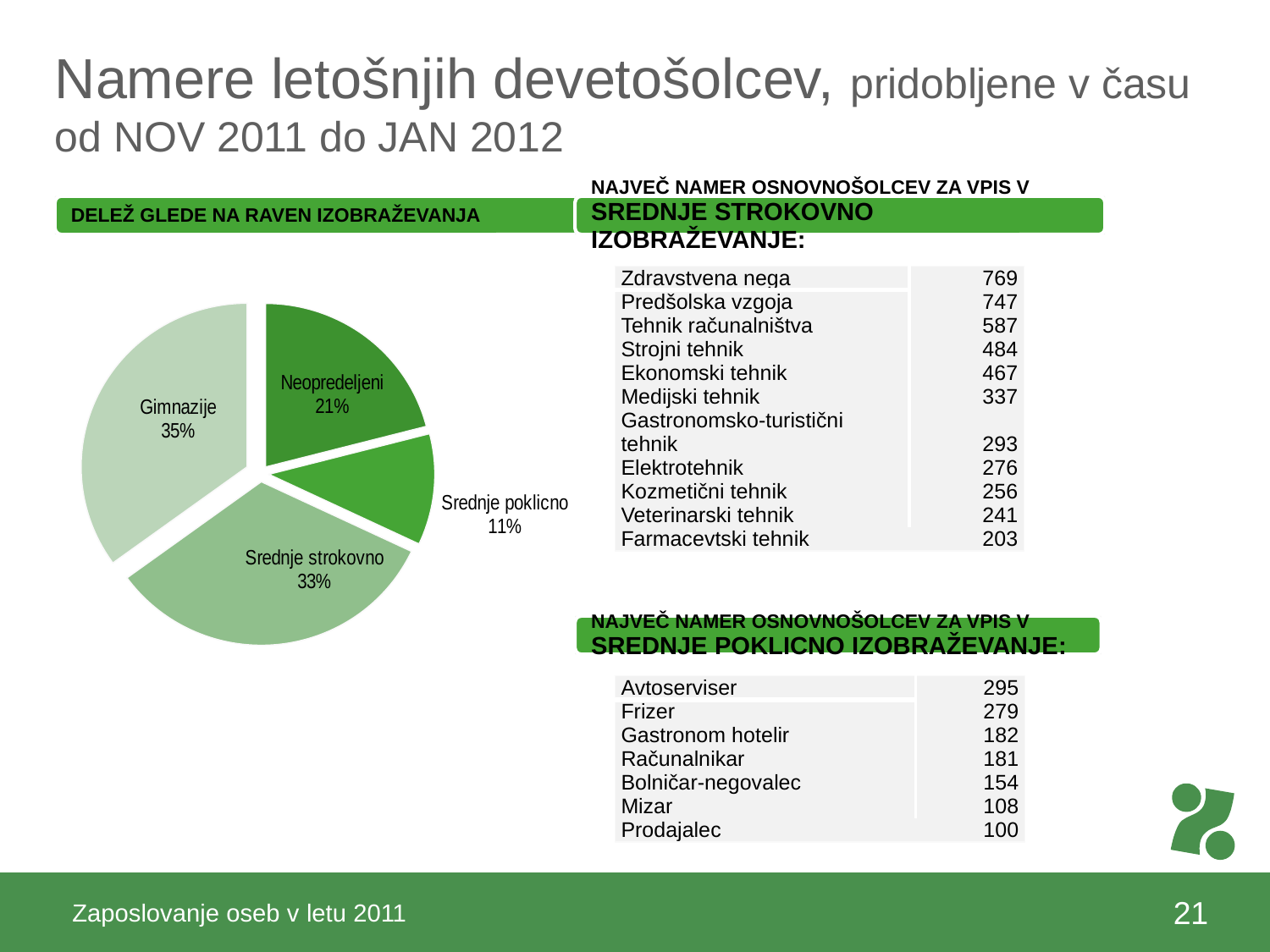
What share of the pie chart is Srednje poklicno? 11% Which slice of the pie chart is the smallest? Srednje poklicno What share of the pie chart is Neopredeljeni? 21% Which slice of the pie chart is the largest? Gimnazije What is the difference in percentage points between the Gimnazije and Neopredeljeni slices? 14 How many slices does the pie chart have? 4 What is the title shown above the pie chart? DELEŽ GLEDE NA RAVEN IZOBRAŽEVANJA What kind of chart is shown on the slide? pie chart What share of the pie chart is Gimnazije? 35% Which is larger in the pie chart, Neopredeljeni or Srednje poklicno? Neopredeljeni What share of the pie chart is Srednje strokovno? 33% What is the difference in percentage points between the Srednje strokovno and Srednje poklicno slices? 22